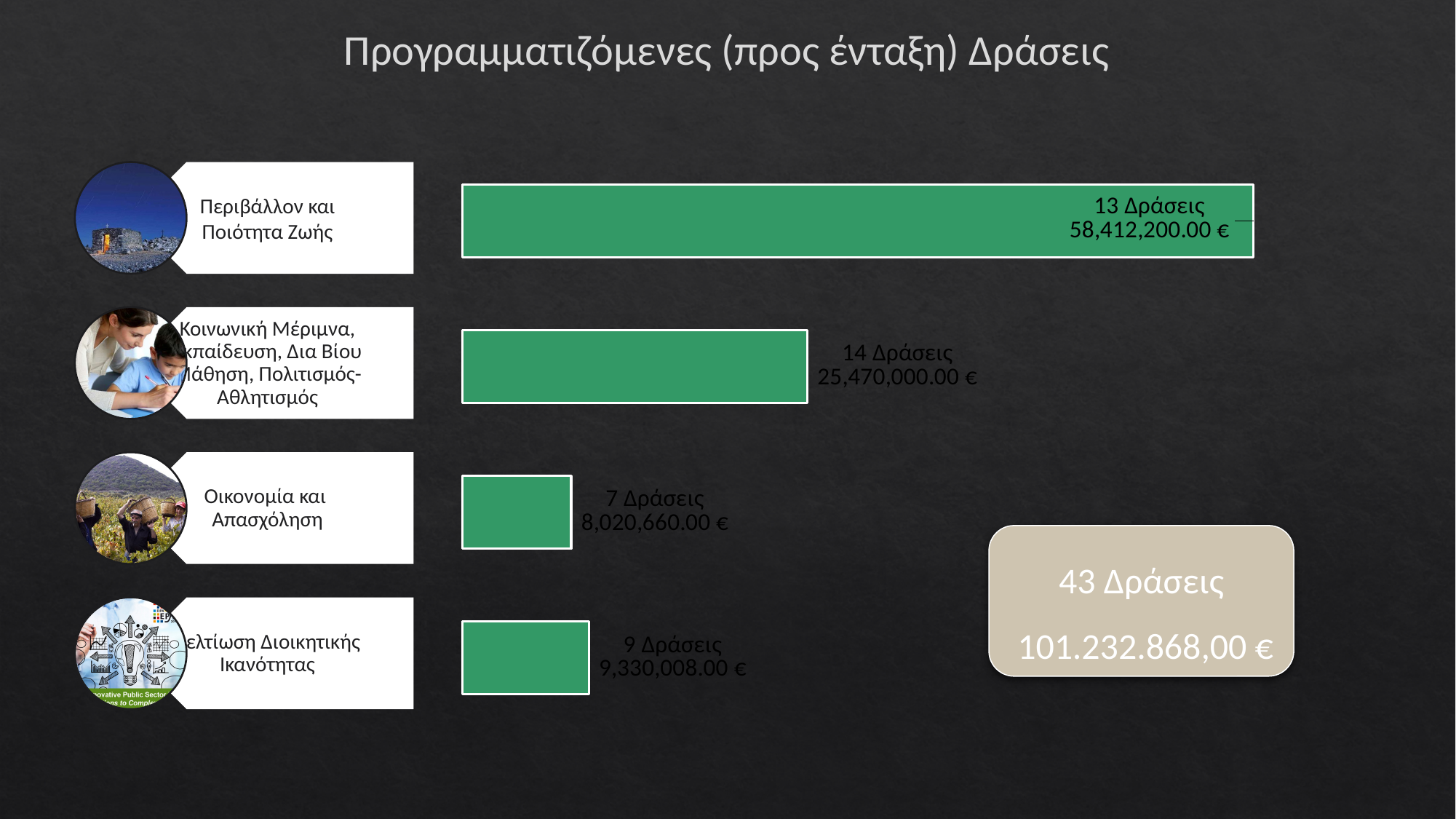
Which has the larger amount: Οικονομία και Απασχόληση or the Διοικητικής Ικανότητας category? Διοικητικής Ικανότητας How many categories (bars) does the chart show? 4 What is the difference in amount between Περιβάλλον και Ποιότητα Ζωής and the Κοινωνική Μέριμνα category? 32,942,200.00 € What is the amount shown for the Διοικητικής Ικανότητας category? 9,330,008.00 € What is the amount shown for Περιβάλλον και Ποιότητα Ζωής? 58,412,200.00 € How many Δράσεις are shown for the Κοινωνική Μέριμνα category? 14 Δράσεις Which category has the smallest amount? Οικονομία και Απασχόληση What kind of chart is shown on the slide? bar chart How many Δράσεις are shown for Περιβάλλον και Ποιότητα Ζωής? 13 Δράσεις What total number of Δράσεις is shown in the summary box on the slide? 43 Δράσεις Which category has the largest amount? Περιβάλλον και Ποιότητα Ζωής What is the amount shown for Οικονομία και Απασχόληση? 8,020,660.00 €